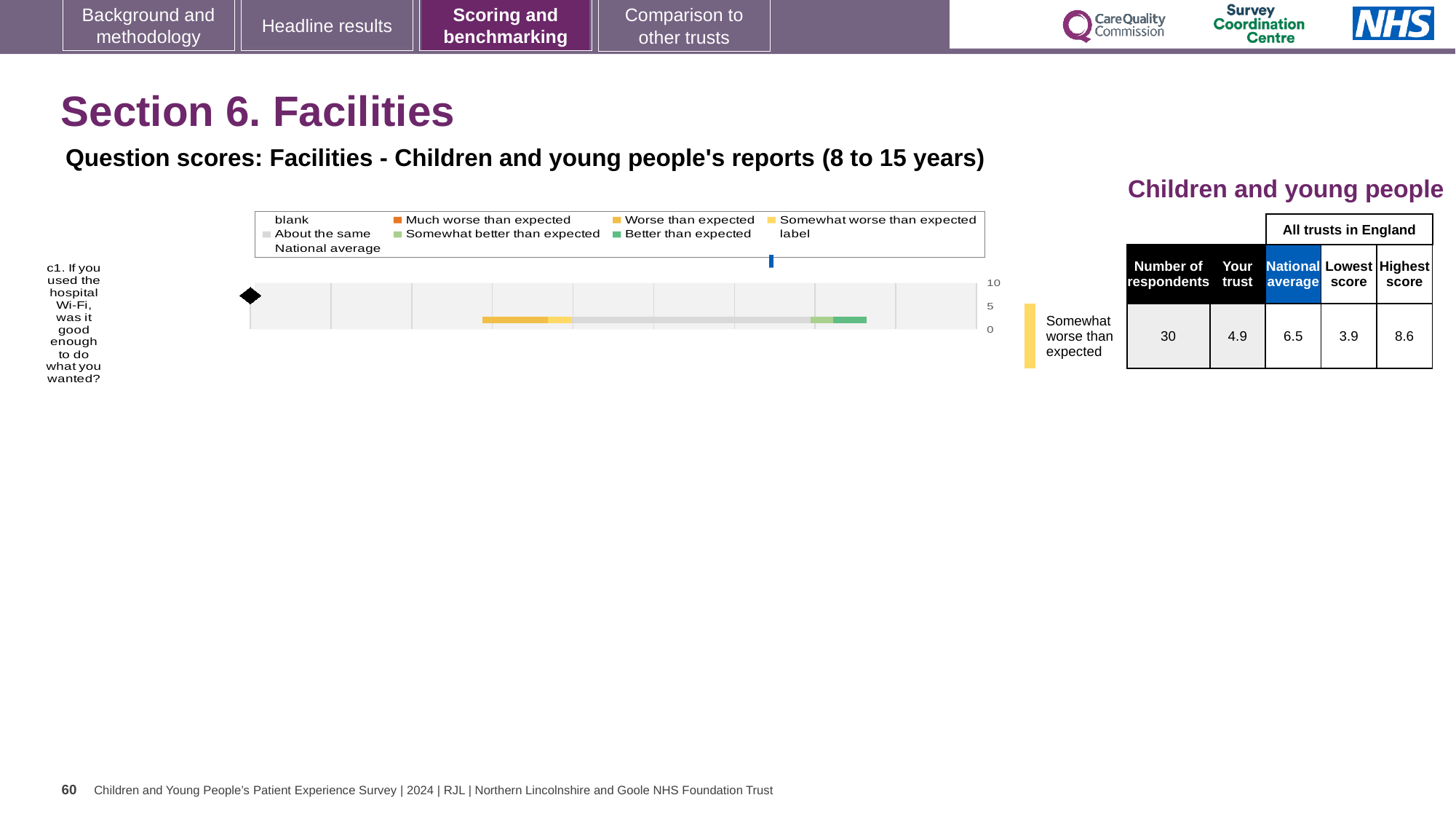
Which legend entry in the chart is shown in dark green? Better than expected What is the highest score among all trusts in England for question c1? 8.6 How many survey questions are plotted in the chart on this slide? 1 What is the difference between the national average and the trust's score for question c1? 1.6 Which is larger for question c1: the trust's score or the national average? National average What is the national average score for question c1 about the hospital Wi-Fi? 6.5 What is the difference between the highest and lowest scores among all trusts in England for question c1? 4.7 What is the trust's score for question c1 about the hospital Wi-Fi? 4.9 How many respondents answered question c1 about the hospital Wi-Fi? 30 What is the lowest score among all trusts in England for question c1? 3.9 Which benchmarking category is the trust's score for question c1 placed in? Somewhat worse than expected What kind of chart is used to show the question score for c1 on this slide? bar chart